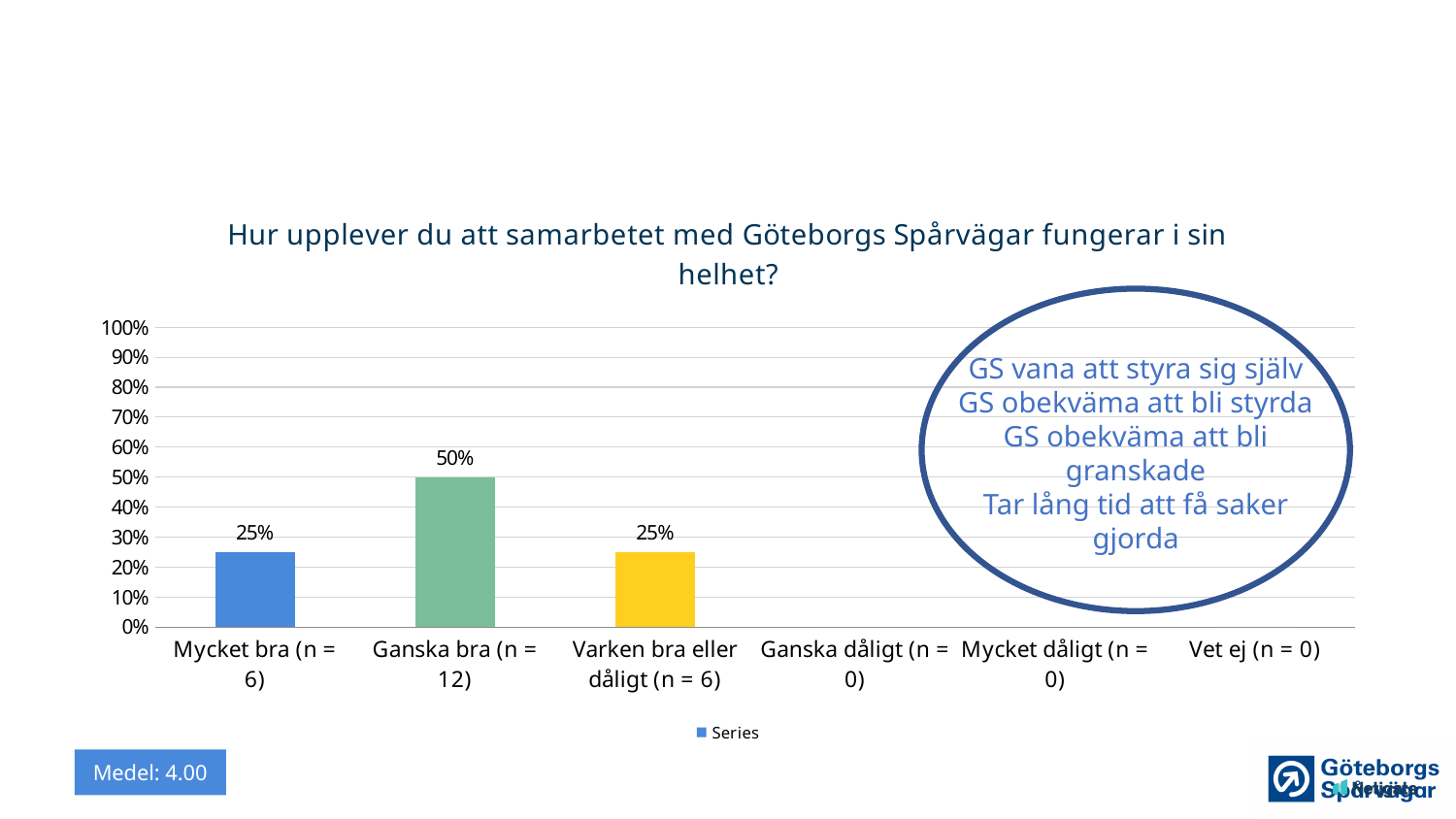
What is the title of the chart? Hur upplever du att samarbetet med Göteborgs Spårvägar fungerar i sin helhet? What is the difference between the values for Ganska bra (n = 12) and Mycket bra (n = 6)? 25% How many categories are shown on the x axis? 6 What kind of chart is shown on the slide? bar chart Which is larger, the value for Ganska bra (n = 12) or the value for Varken bra eller dåligt (n = 6)? Ganska bra (n = 12) What is the value for Mycket bra (n = 6)? 25% Which category has the highest value? Ganska bra (n = 12) What is the value for Ganska bra (n = 12)? 50% How many series does the legend list? 1 Is the value for Mycket bra (n = 6) greater or less than 30%? less What is the value for Varken bra eller dåligt (n = 6)? 25% Is the value for Ganska bra (n = 12) greater or less than 40%? greater